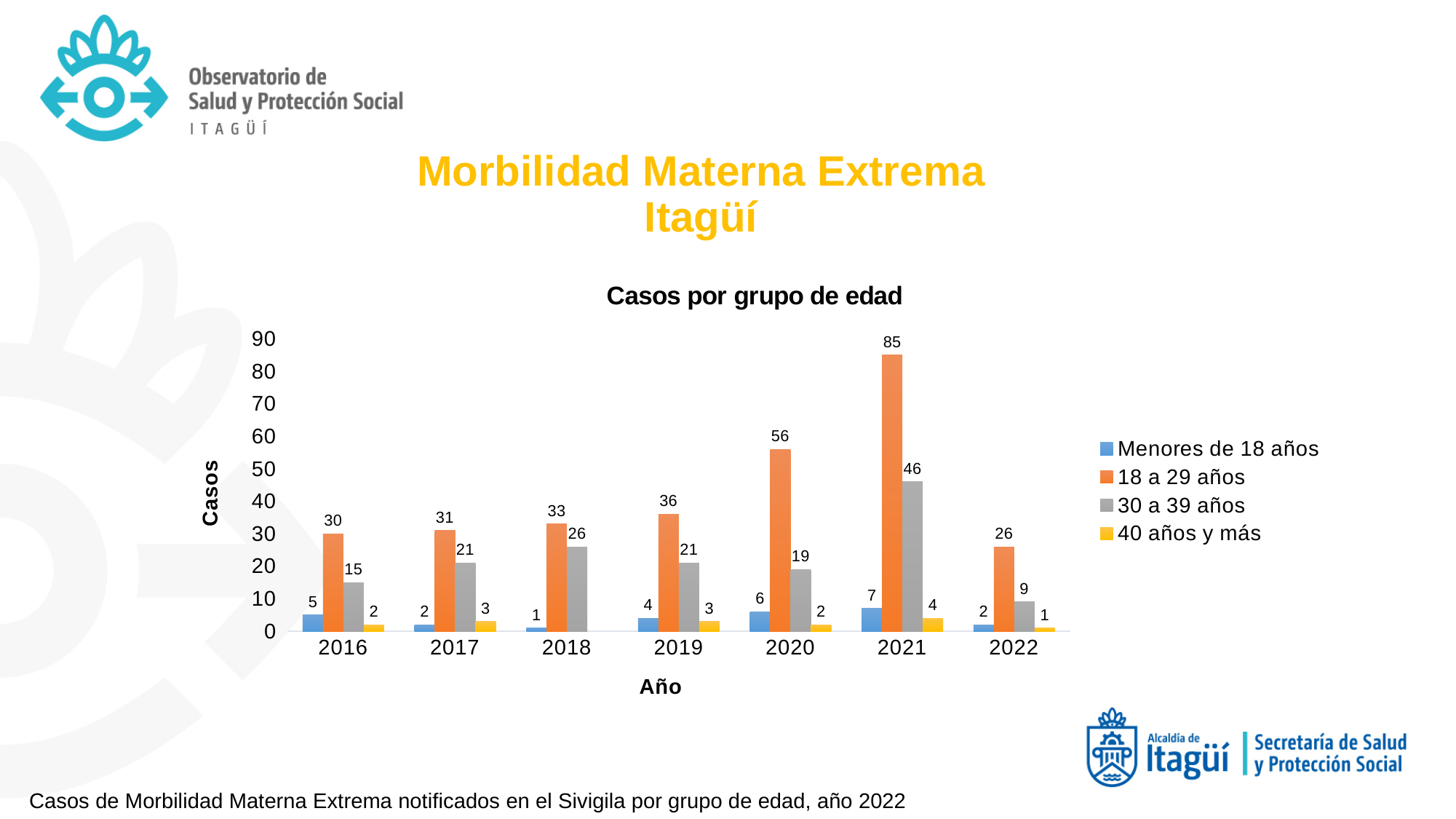
What is the value for the Menores de 18 años series in 2020? 6 How many years are shown on the x axis? 7 What is the value for the 18 a 29 años series in 2021? 85 What is the value for the 40 años y más series in 2021? 4 In which year is the 18 a 29 años series highest? 2021 In 2021, what is the difference between the 18 a 29 años value and the 30 a 39 años value? 39 Which year has the larger value for the 18 a 29 años series, 2019 or 2020? 2020 How many series does the legend list? 4 What kind of chart is shown on the slide? Bar chart What is the value for the 30 a 39 años series in 2018? 26 Does the 18 a 29 años series rise or fall from 2016 to 2021? Rise In which year is the 30 a 39 años series lowest? 2022